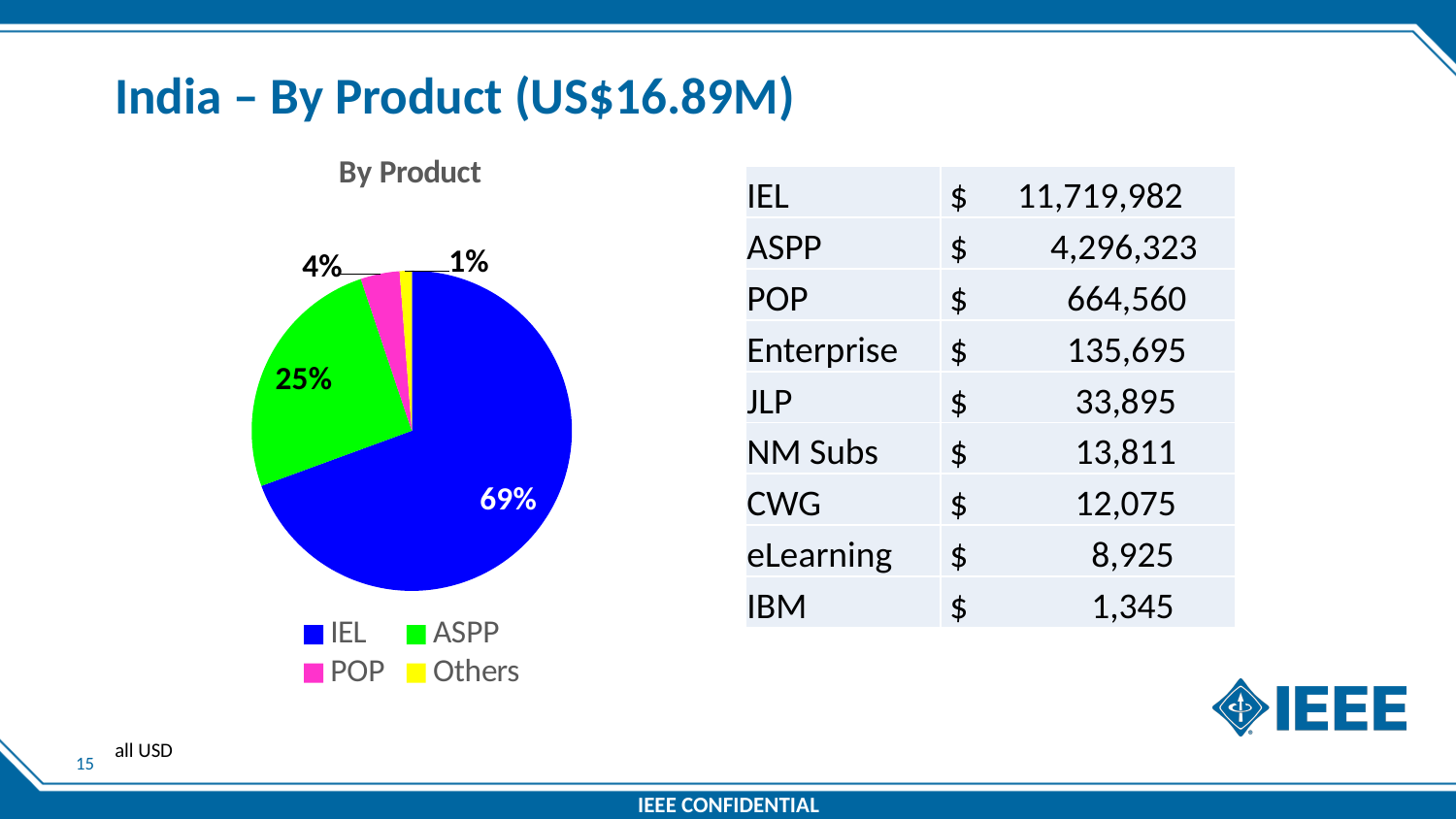
What share of the pie does POP represent? 4% Which slice is larger, POP or ASPP? ASPP What is the difference in percentage points between the IEL and ASPP slices? 44 What share of the pie does IEL represent? 69% Which category has the smallest slice of the pie? Others Which category has the largest slice of the pie? IEL What is the title of the chart? By Product What share of the pie does Others represent? 1% How many slices does the pie chart have? 4 What colour is the IEL slice in the pie chart? blue What kind of chart is shown on the slide? pie chart